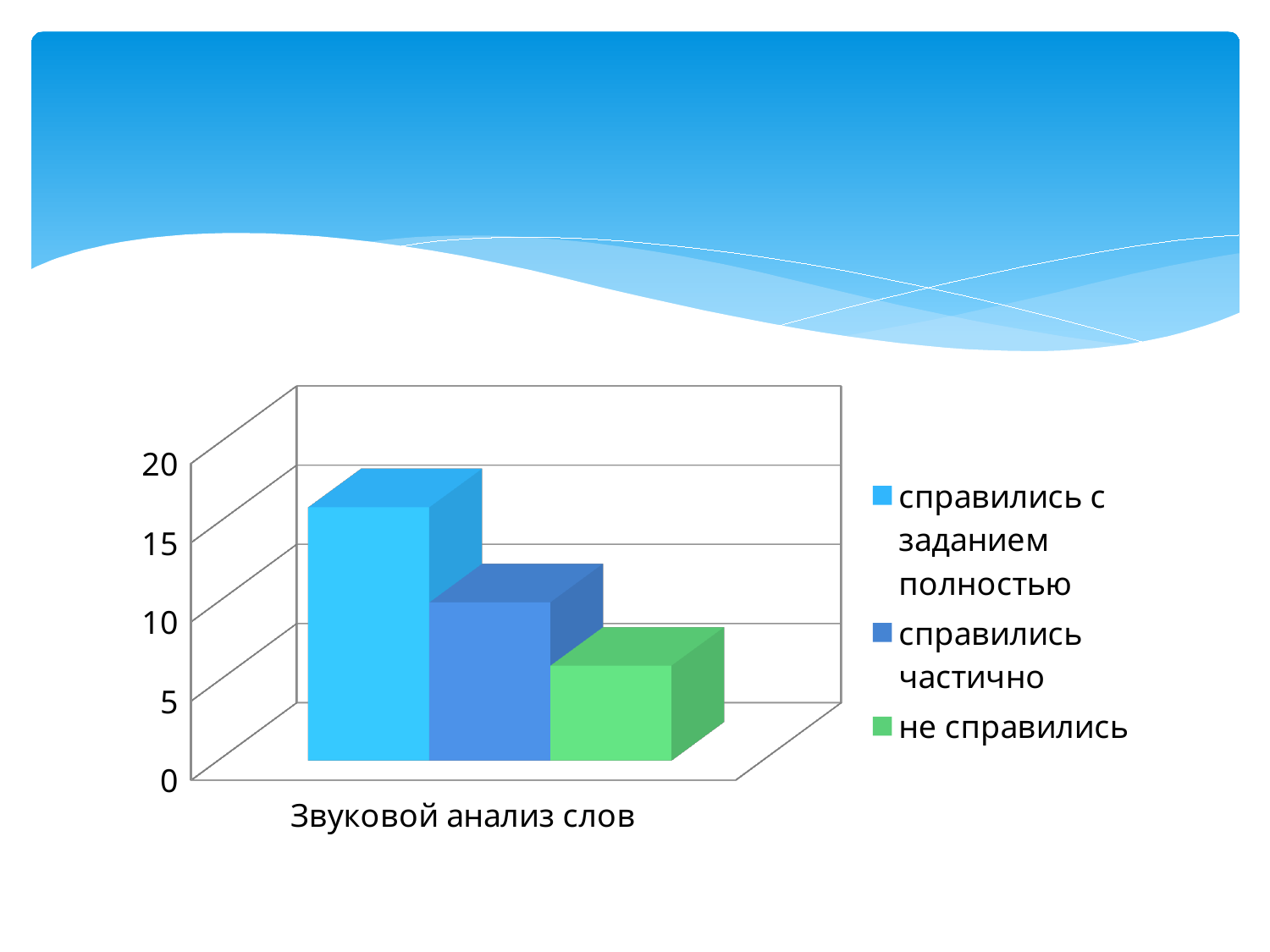
Which series has the highest value? справились с заданием полностью Is the value for "справились с заданием полностью" greater or less than 15? greater Which is larger, the value for "справились частично" or the value for "не справились"? справились частично What kind of chart is shown on the slide? bar chart How many categories are shown on the x axis? 1 How many series does the legend list? 3 What is the category label on the x axis? Звуковой анализ слов Is the value for "не справились" greater or less than 10? less Which is larger, the value for "справились с заданием полностью" or the value for "справились частично"? справились с заданием полностью What colour is the bar for "не справились"? green Which series has the lowest value? не справились Is the value for "справились частично" greater or less than 15? less